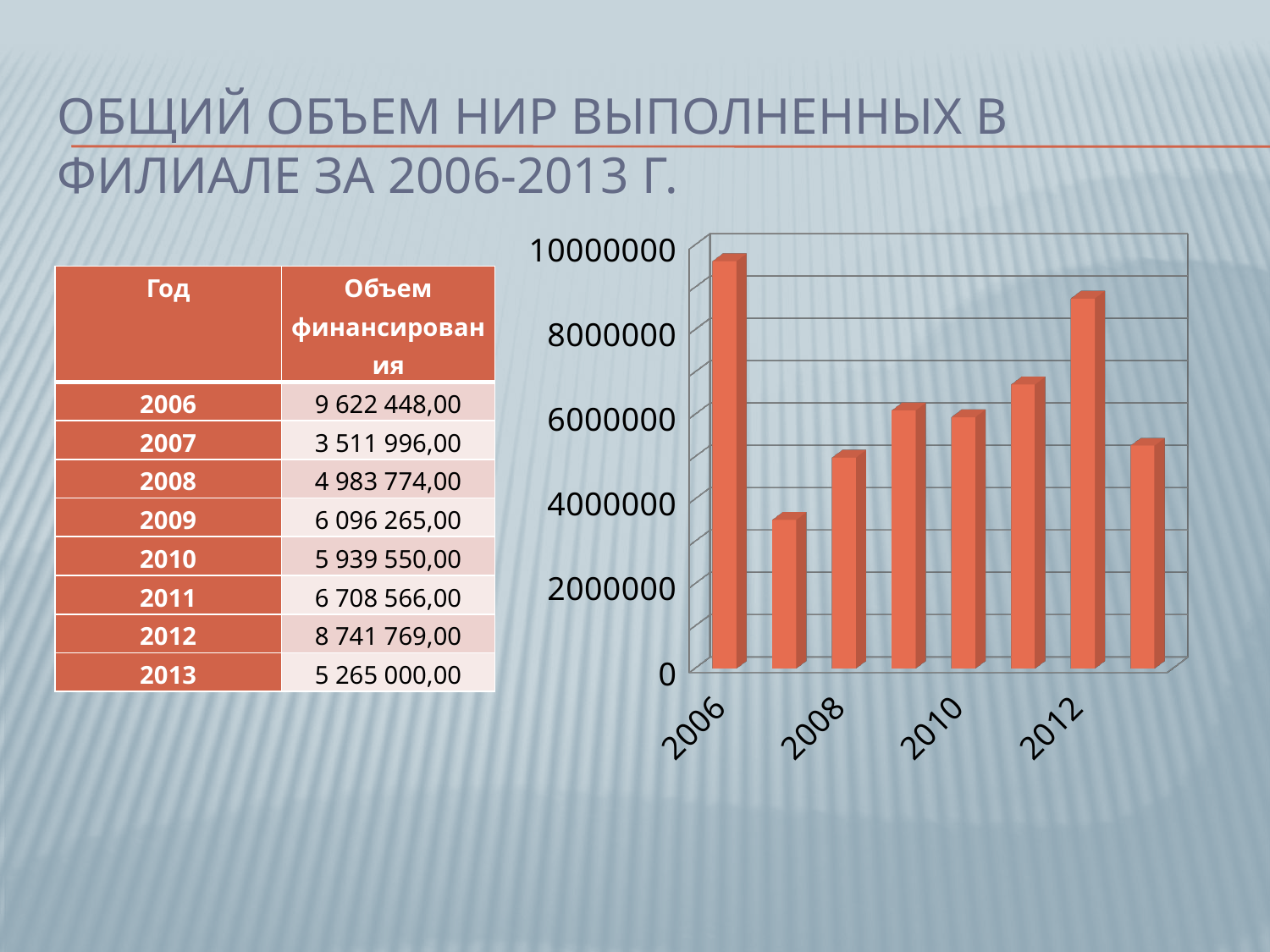
How many bars (years) does the chart show? 8 What is the volume of financing for 2013? 5 265 000,00 What is the difference between the values for 2006 and 2012? 880 679,00 Is the value for 2012 greater or less than 8000000? greater Which year has the lowest volume of financing? 2007 What is the volume of financing for 2012? 8 741 769,00 Is the value for 2007 greater or less than 4000000? less Do the values rise or fall from 2007 to 2009? rise Which year has the highest volume of financing? 2006 What kind of chart is shown on the slide? bar chart Which is larger, the value for 2011 or the value for 2013? 2011 What is the volume of financing for 2006? 9 622 448,00